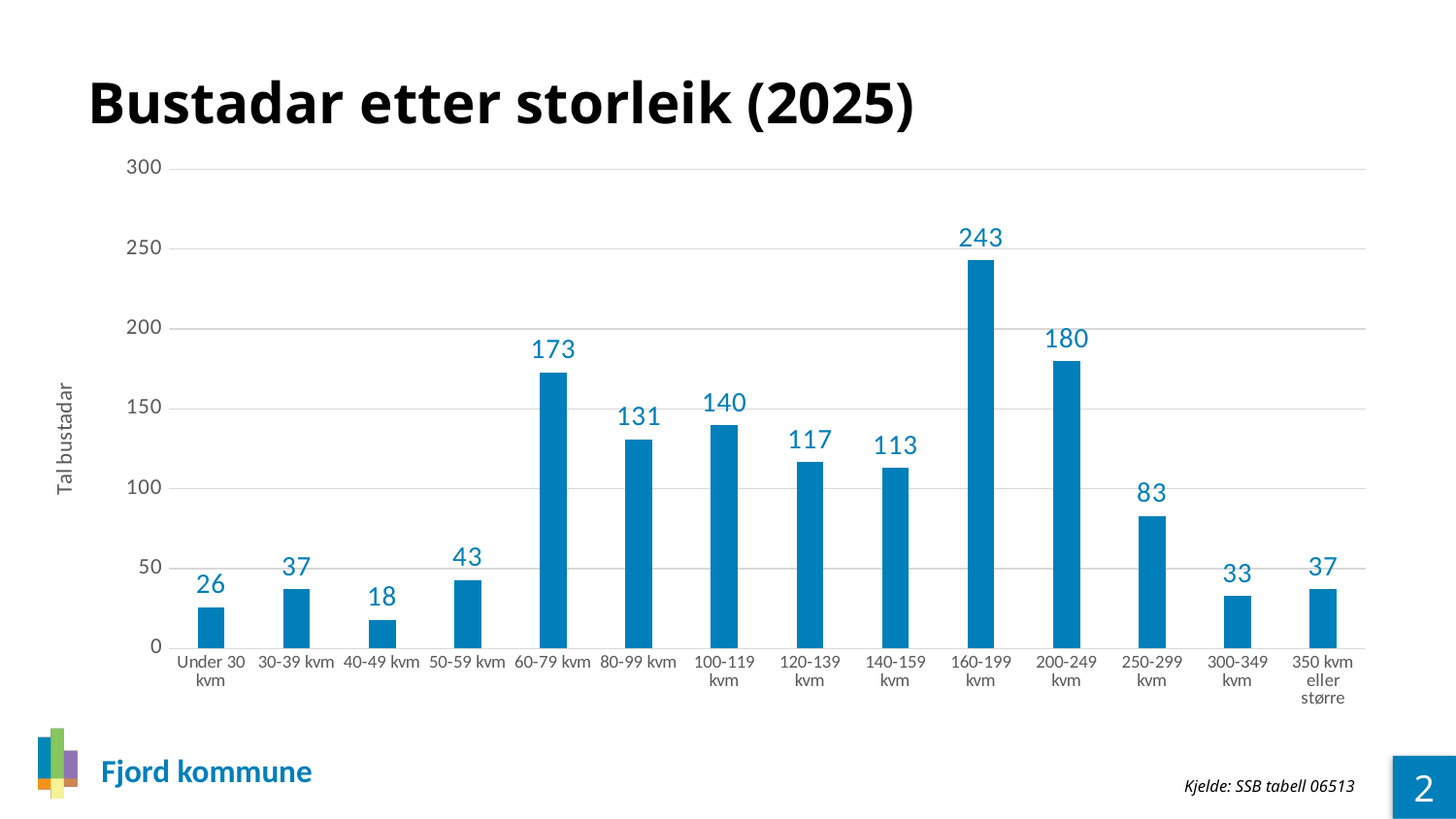
What is the value for 250-299 kvm? 83 Which category has the lowest value? 40-49 kvm What kind of chart is shown on the slide? bar chart What is the difference between the values for 160-199 kvm and 200-249 kvm? 63 What is the value for Under 30 kvm? 26 Which is larger, the value for 60-79 kvm or the value for 100-119 kvm? 60-79 kvm What is the label of the y axis? Tal bustadar Which category has the highest value? 160-199 kvm What is the title of the chart? Bustadar etter storleik (2025) Is the value for 80-99 kvm greater or less than 100? greater How many categories are shown on the x axis? 14 What is the value for 160-199 kvm? 243